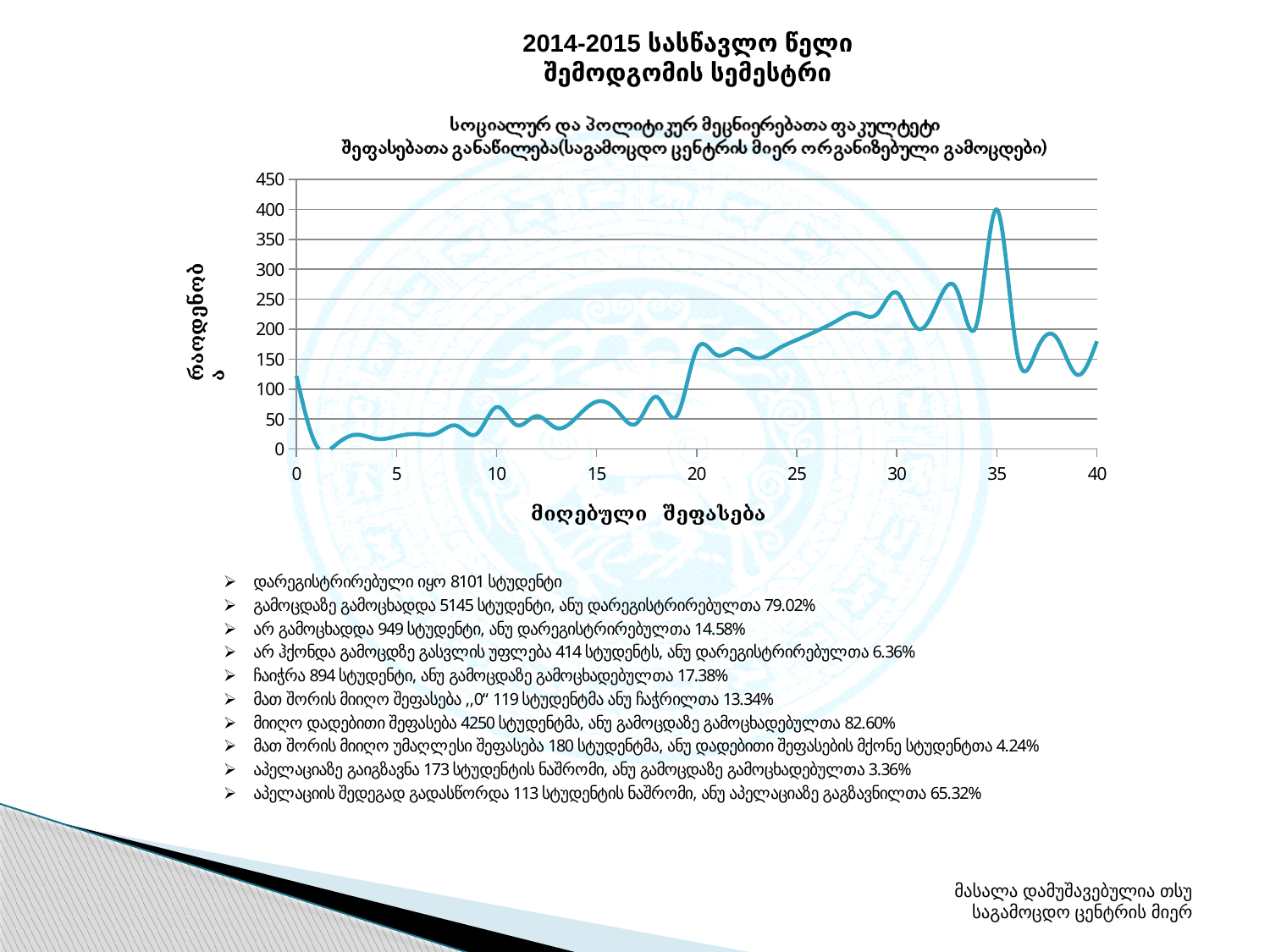
Is the value of the line at x = 5 greater or less than 50? less Is the value of the line at x = 20 greater or less than 100? greater Is the value of the line at x = 10 greater or less than 100? less Which is larger: the value of the line at x = 35 or at x = 30? x = 35 Which is larger: the value of the line at x = 20 or at x = 10? x = 20 What is the label of the horizontal axis? მიღებული შეფასება At which x-axis value (received score) does the line reach its highest point? 35 What is the highest tick value shown on the vertical axis? 450 What kind of chart is shown on the slide? line chart